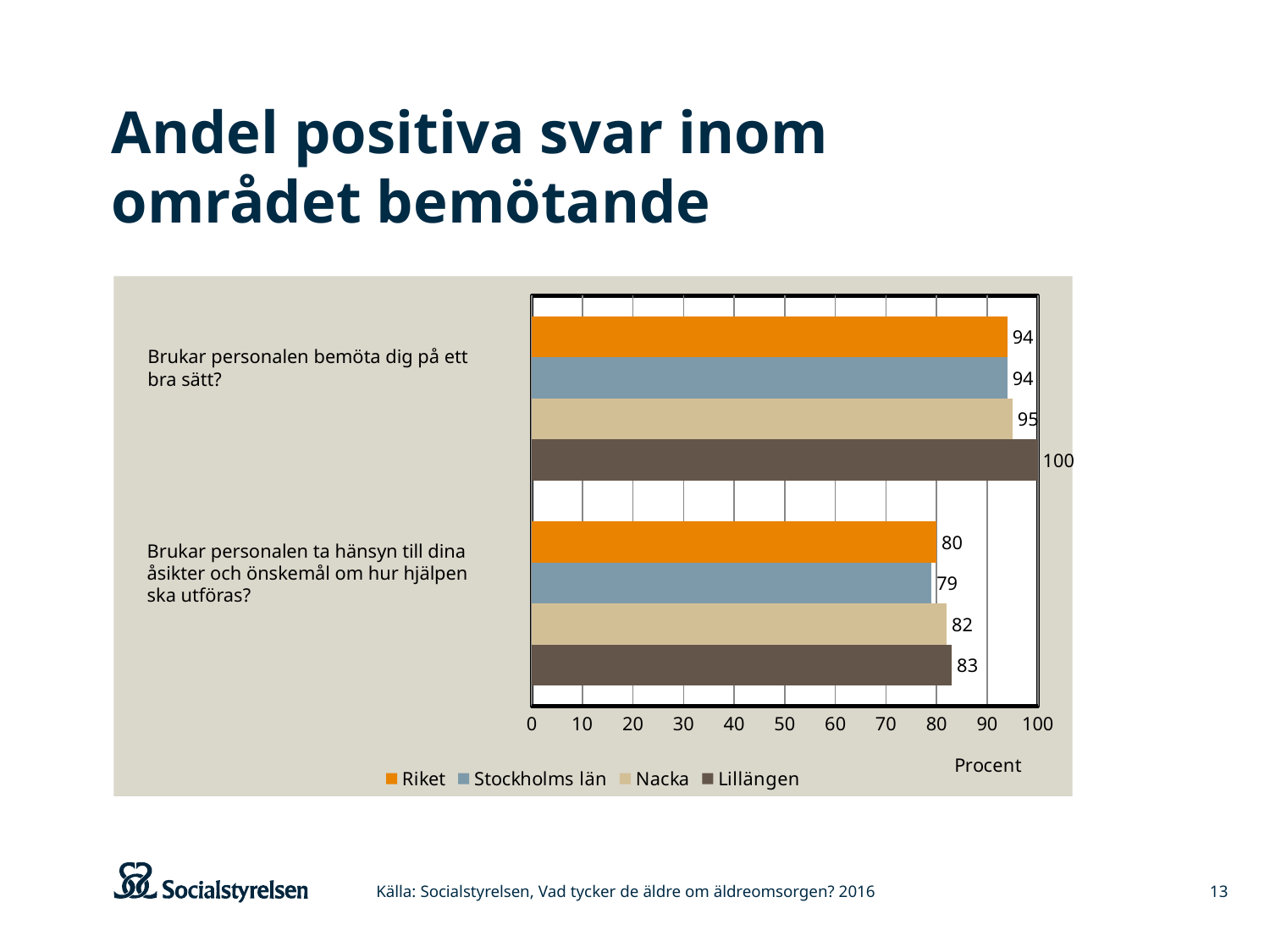
How many questions (categories) are shown on the chart? 2 What kind of chart is shown on the slide? Bar chart What is the value for Stockholms län on the question "Brukar personalen ta hänsyn till dina åsikter och önskemål om hur hjälpen ska utföras?"? 79 What is the value for Lillängen on the question "Brukar personalen bemöta dig på ett bra sätt?"? 100 What is the value for Nacka on the question "Brukar personalen bemöta dig på ett bra sätt?"? 95 Which is larger for Nacka: the value for "Brukar personalen bemöta dig på ett bra sätt?" or for "Brukar personalen ta hänsyn till dina åsikter och önskemål om hur hjälpen ska utföras?"? Brukar personalen bemöta dig på ett bra sätt? What is the difference between Lillängen and Riket on the question "Brukar personalen bemöta dig på ett bra sätt?"? 6 How many series does the legend list? 4 What is the value for Riket on the question "Brukar personalen ta hänsyn till dina åsikter och önskemål om hur hjälpen ska utföras?"? 80 Which series has the lowest value on the question "Brukar personalen ta hänsyn till dina åsikter och önskemål om hur hjälpen ska utföras?"? Stockholms län What is the label of the horizontal axis? Procent Which series has the highest value on the question "Brukar personalen ta hänsyn till dina åsikter och önskemål om hur hjälpen ska utföras?"? Lillängen